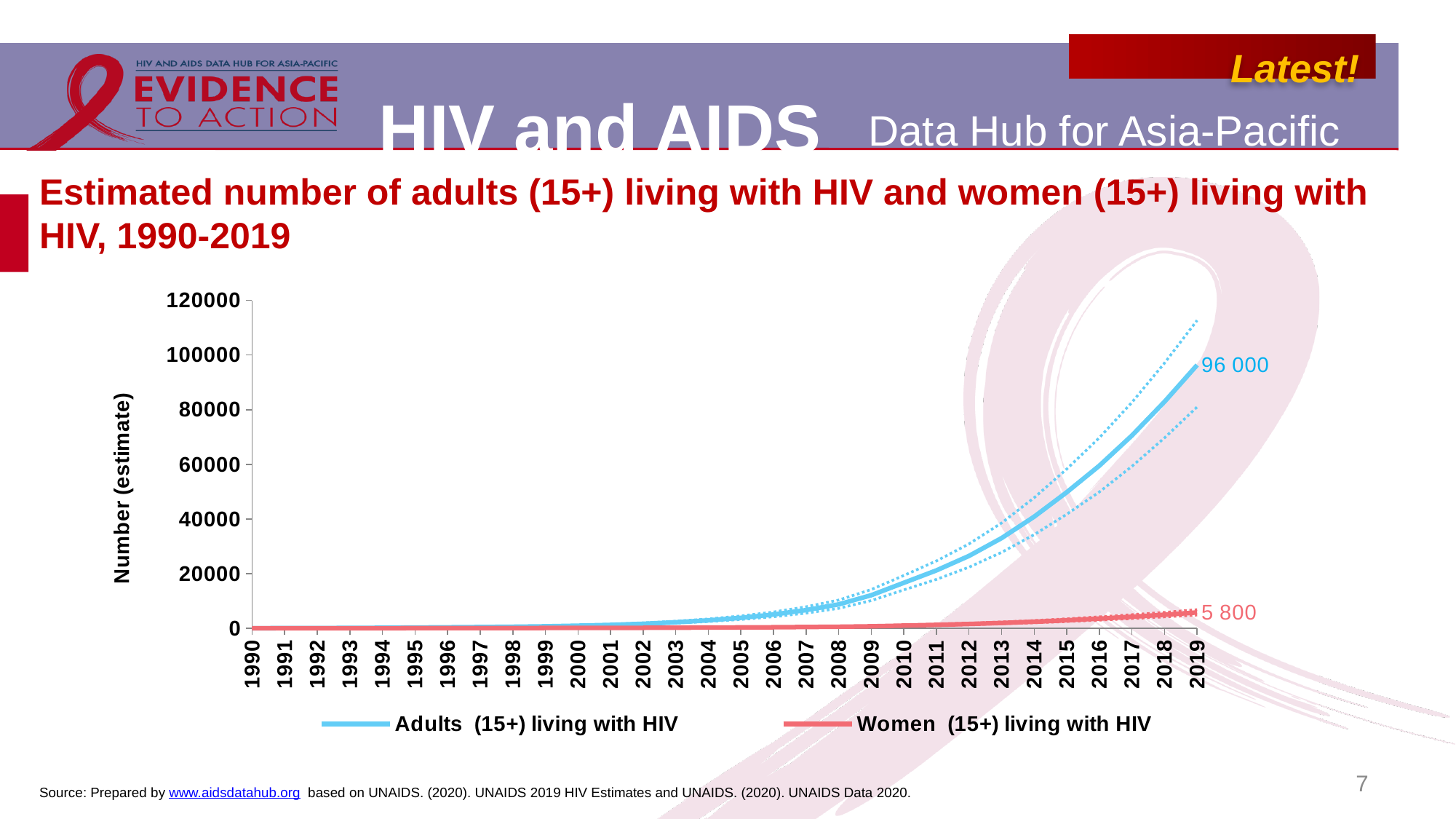
Does the number of adults (15+) living with HIV rise or fall from 1990 to 2019? Rise How many series does the legend list? 2 What is the label of the y axis? Number (estimate) What colour is the line for women (15+) living with HIV? Red What is the difference between the 2019 values for adults (15+) living with HIV and women (15+) living with HIV? 90 200 Is the value for adults (15+) living with HIV in 2019 greater or less than 80000? greater In 2019, which series has the larger value: adults (15+) living with HIV or women (15+) living with HIV? Adults (15+) living with HIV Is the value for women (15+) living with HIV in 2019 greater or less than 20000? less What is the estimated number of adults (15+) living with HIV in 2019? 96 000 What kind of chart is shown on the slide? Line chart Is the value for adults (15+) living with HIV in 2010 greater or less than 40000? less What is the estimated number of women (15+) living with HIV in 2019? 5 800